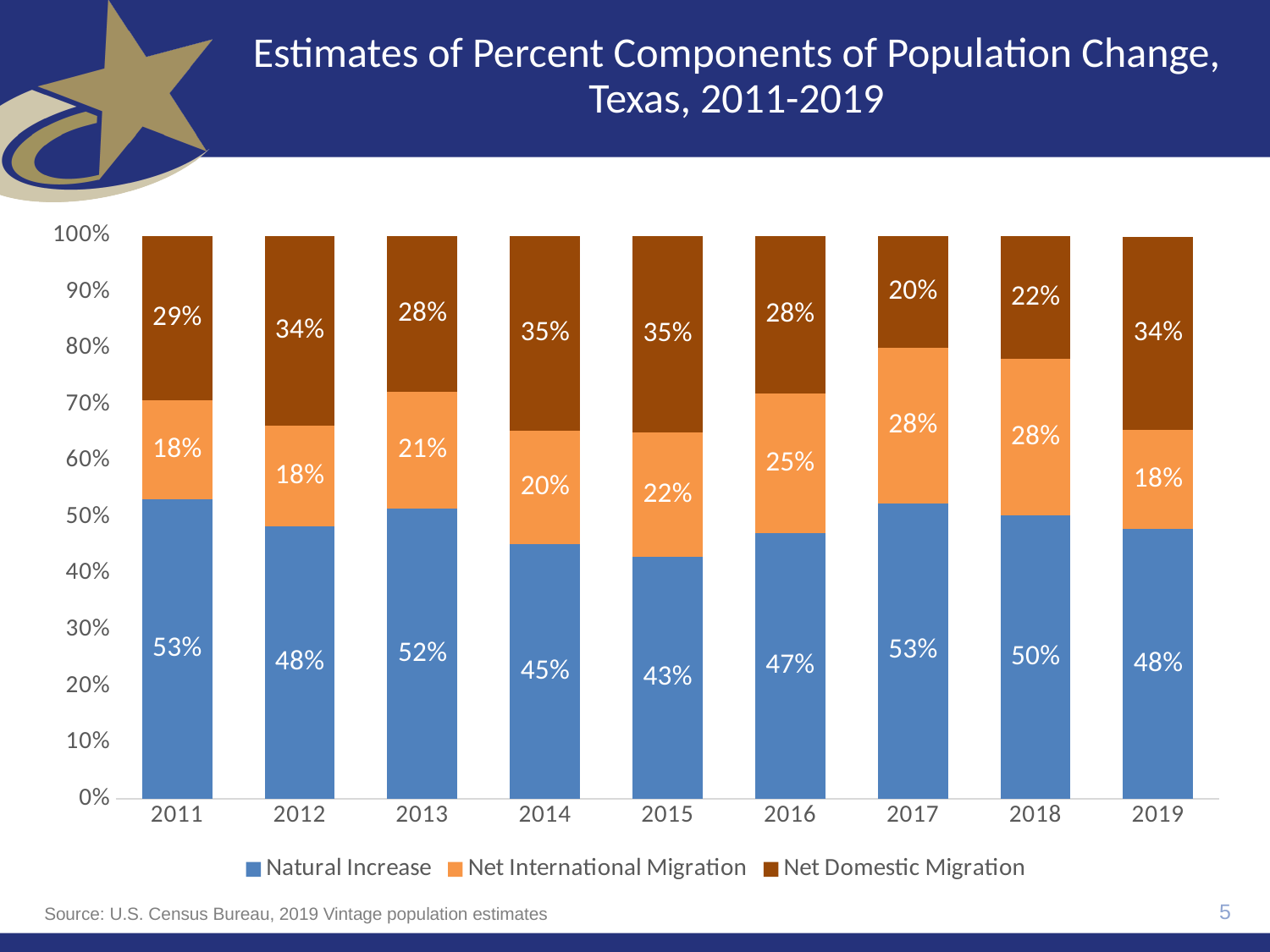
What is the Net International Migration percentage for 2016? 25% What type of chart is shown on the slide? Stacked bar chart What is the Net Domestic Migration percentage for 2014? 35% Which year has the lowest Net Domestic Migration percentage? 2017 How many years are shown on the x axis? 9 Which is larger, the Net International Migration percentage in 2017 or in 2019? 2017 What is the total of the three components for the 2011 bar? 100% What is the Natural Increase percentage for 2015? 43% What is the difference between the Net Domestic Migration percentage in 2012 and in 2013? 6% Which year has the lowest Natural Increase percentage? 2015 How many series does the legend list? 3 Which series is shown in dark brown in the legend? Net Domestic Migration